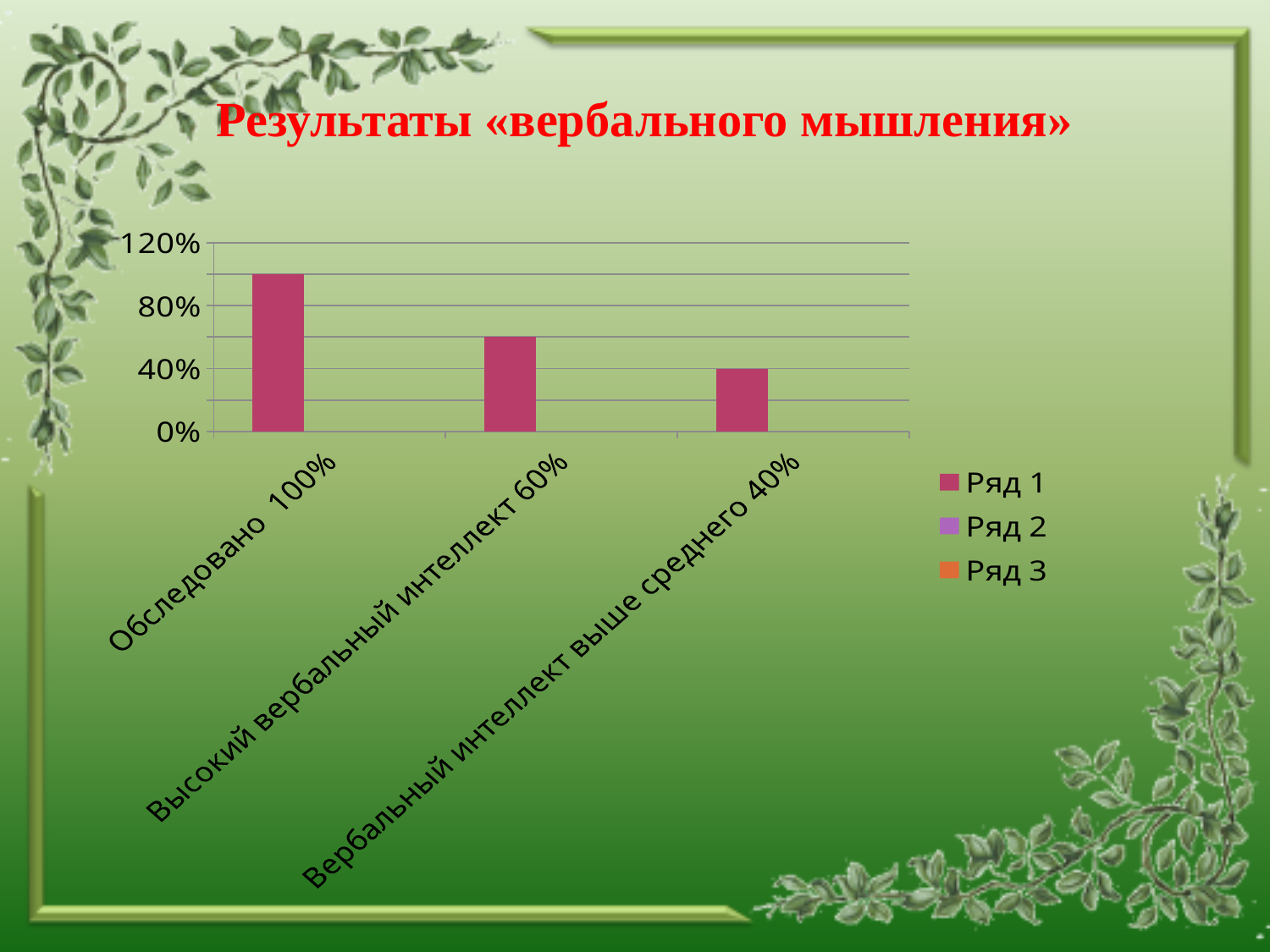
What is the value for the category "Обследовано"? 100% What is the title of the slide's chart? Результаты «вербального мышления» Do the bar values rise or fall from left to right along the x axis? fall Which is larger: the value for "Обследовано" or the value for "Высокий вербальный интеллект"? Обследовано What is the difference between the values for "Высокий вербальный интеллект" and "Вербальный интеллект выше среднего"? 20% How many categories are plotted in the chart? 3 Which category has the highest value? Обследовано What is the value for the category "Вербальный интеллект выше среднего"? 40% Which category has the lowest value? Вербальный интеллект выше среднего What type of chart is shown on the slide? bar chart How many series does the legend list? 3 What is the value for the category "Высокий вербальный интеллект"? 60%